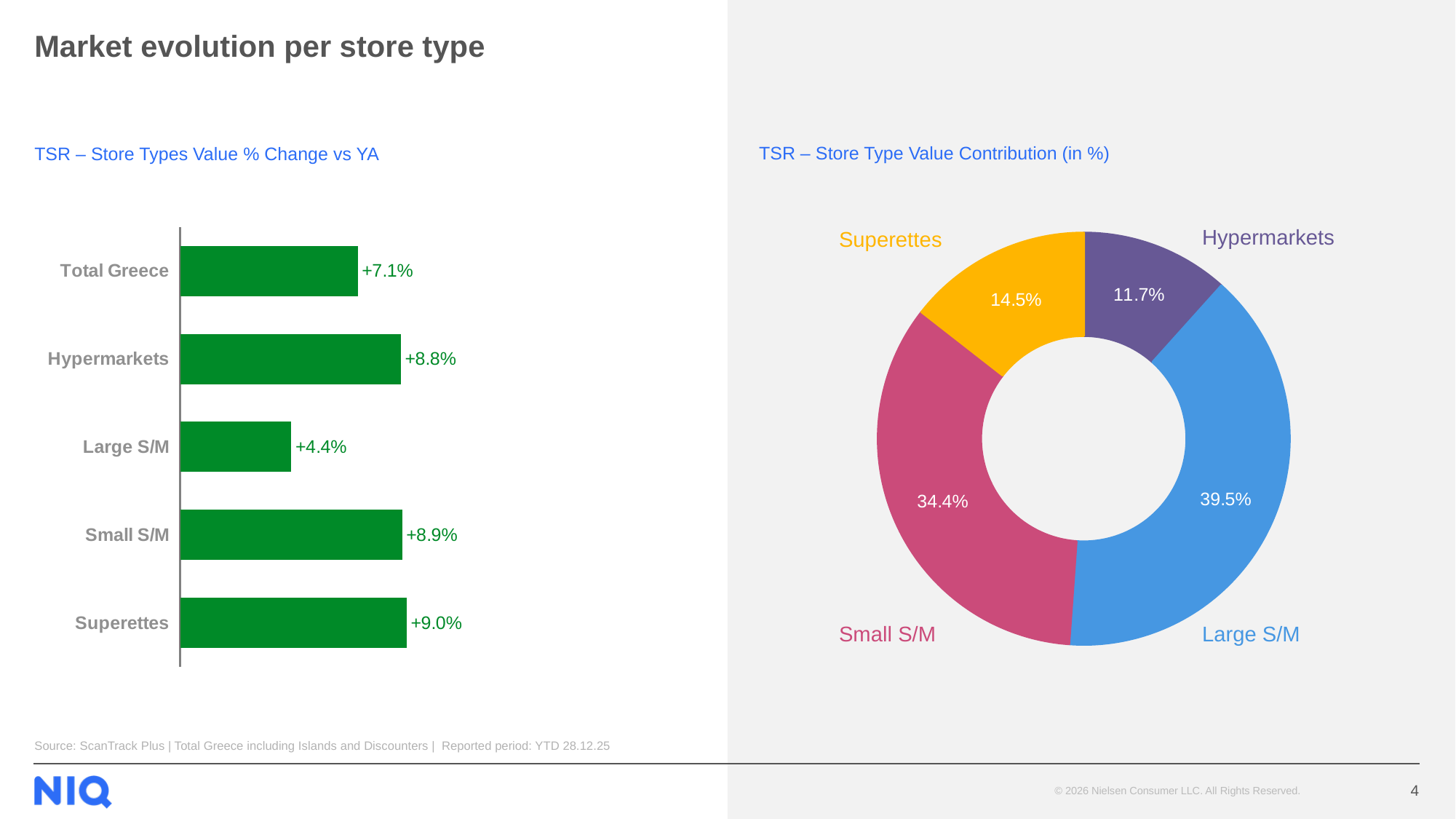
In the 'TSR – Store Types Value % Change vs YA' chart, what is the value for Hypermarkets? +8.8% What kind of chart is the 'TSR – Store Types Value % Change vs YA' chart? Bar chart In the 'TSR – Store Types Value % Change vs YA' chart, what is the value for Large S/M? +4.4% In the 'TSR – Store Types Value % Change vs YA' chart, which store type has the highest value? Superettes What kind of chart is the 'TSR – Store Type Value Contribution (in %)' chart? Doughnut chart In the 'TSR – Store Type Value Contribution (in %)' chart, which store type has the largest share? Large S/M In the 'TSR – Store Types Value % Change vs YA' chart, how many categories are shown? 5 In the 'TSR – Store Type Value Contribution (in %)' chart, what is the share for Small S/M? 34.4% In the 'TSR – Store Type Value Contribution (in %)' chart, which store type has the smallest share? Hypermarkets In the 'TSR – Store Types Value % Change vs YA' chart, what is the difference between the values for Small S/M and Large S/M? 4.5 percentage points In the 'TSR – Store Types Value % Change vs YA' chart, which store type has the lowest value? Large S/M In the 'TSR – Store Type Value Contribution (in %)' chart, which is larger: the share for Superettes or the share for Hypermarkets? Superettes